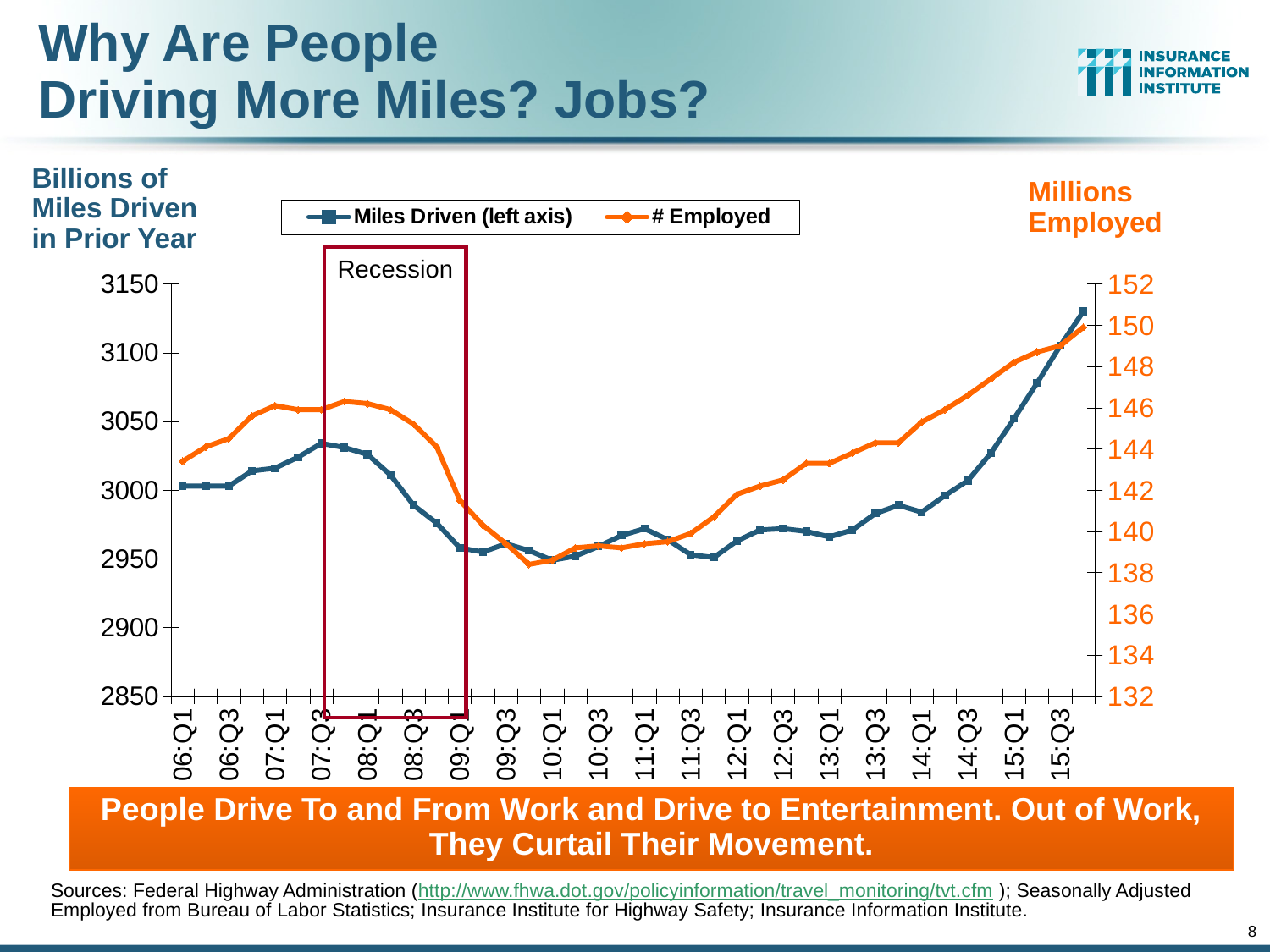
Is the Miles Driven value at 09:Q1 greater or less than 3000? less How many series does the legend list? 2 Does the Miles Driven series rise or fall between 07:Q3 and 09:Q1? fall Is the # Employed value at 09:Q3 greater or less than 140? less What kind of chart is shown on the slide? Line chart Does the # Employed series rise or fall between 13:Q1 and 15:Q3? rise Which series is plotted against the left axis according to the legend? Miles Driven Is the # Employed value at 15:Q3 greater or less than 148? greater What period is marked by the red box on the chart? Recession